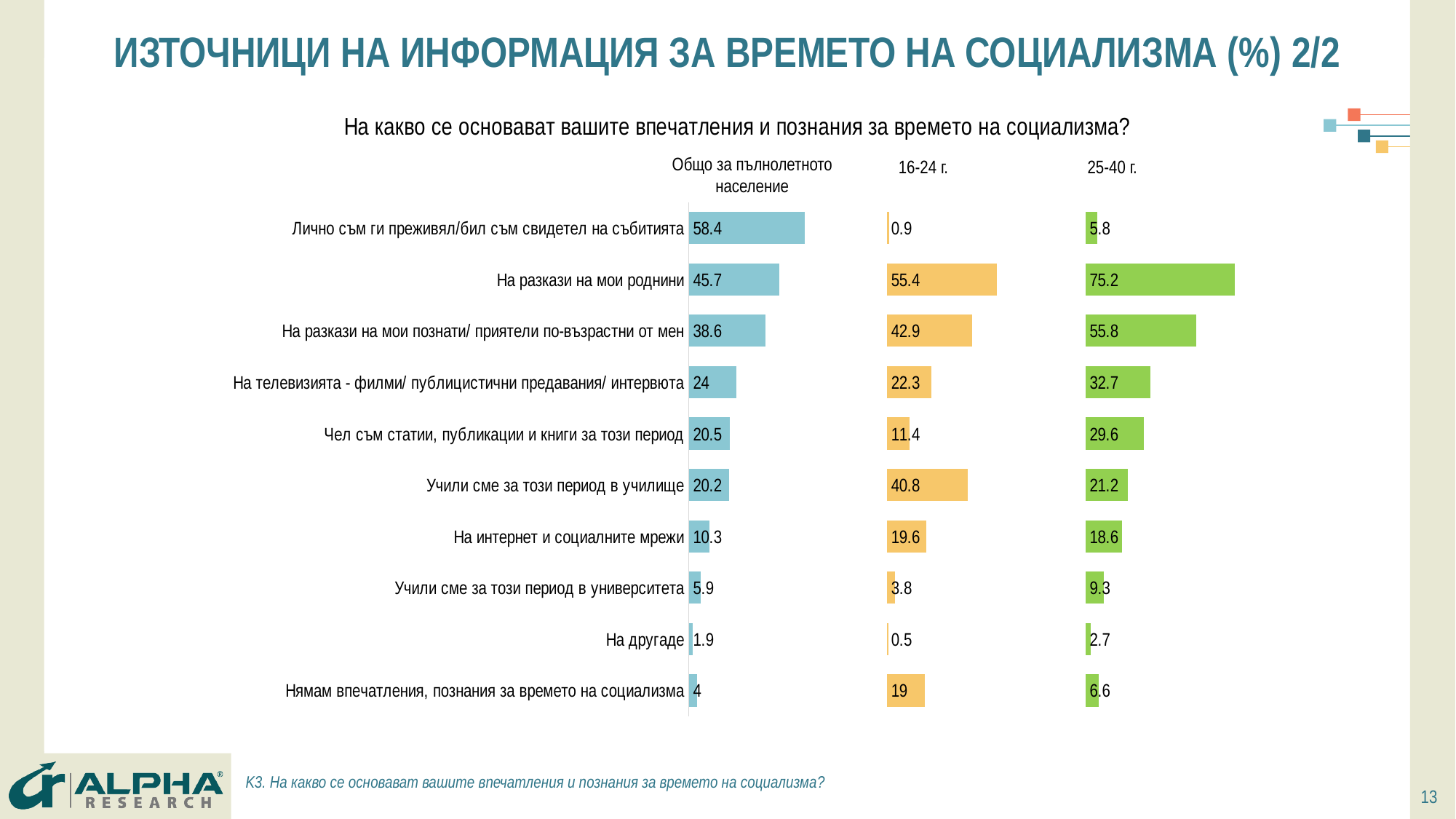
In the chart '16-24 г.', what is the value for 'Учили сме за този период в училище'? 40.8 What colour are the bars in the chart '16-24 г.'? Orange In the chart '25-40 г.', what is the value for 'На разкази на мои роднини'? 75.2 In the chart '16-24 г.', what is the difference between 'Нямам впечатления, познания за времето на социализма' and 'На интернет и социалните мрежи'? 0.6 In the chart 'Общо за пълнолетното население', what is the value for 'Лично съм ги преживял/бил съм свидетел на събитията'? 58.4 In the chart '16-24 г.', which category has the lowest value? На другаде In the chart '25-40 г.', which category has the lowest value? На другаде In the chart '25-40 г.', what is the difference between 'На разкази на мои роднини' and 'На разкази на мои познати/ приятели по-възрастни от мен'? 19.4 Which is larger: the value for 'На телевизията - филми/ публицистични предавания/ интервюта' in the chart '16-24 г.' or in the chart '25-40 г.'? 25-40 г. In the chart '16-24 г.', which category has the highest value? На разкази на мои роднини What type of chart is used for the '25-40 г.' data? Bar chart How many categories are shown in the chart 'Общо за пълнолетното население'? 10